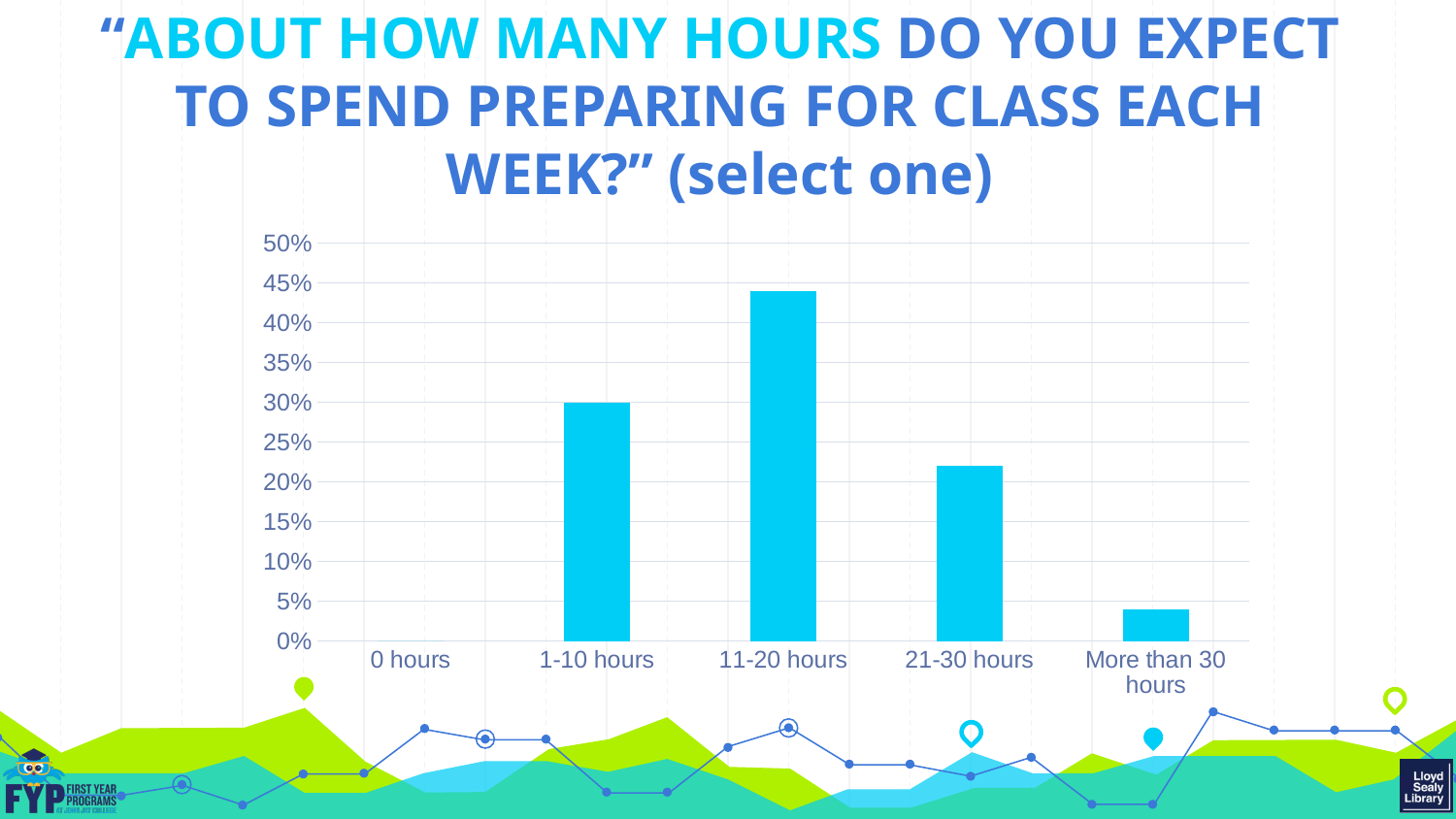
Is the value for 1-10 hours greater or less than 25%? greater What kind of chart is shown on the slide? bar chart How many categories are shown on the x axis of the chart? 5 Which category has the highest bar in the chart? 11-20 hours Which category has the shortest visible bar in the chart? More than 30 hours Which is larger, the value for 11-20 hours or the value for 1-10 hours? 11-20 hours What is the highest tick value shown on the y axis of the chart? 50% Is the value for 11-20 hours greater or less than 40%? greater Is the value for 21-30 hours greater or less than 25%? less What is the title of the chart on the slide? "ABOUT HOW MANY HOURS DO YOU EXPECT TO SPEND PREPARING FOR CLASS EACH WEEK?" (select one) Which is larger, the value for 1-10 hours or the value for 21-30 hours? 1-10 hours